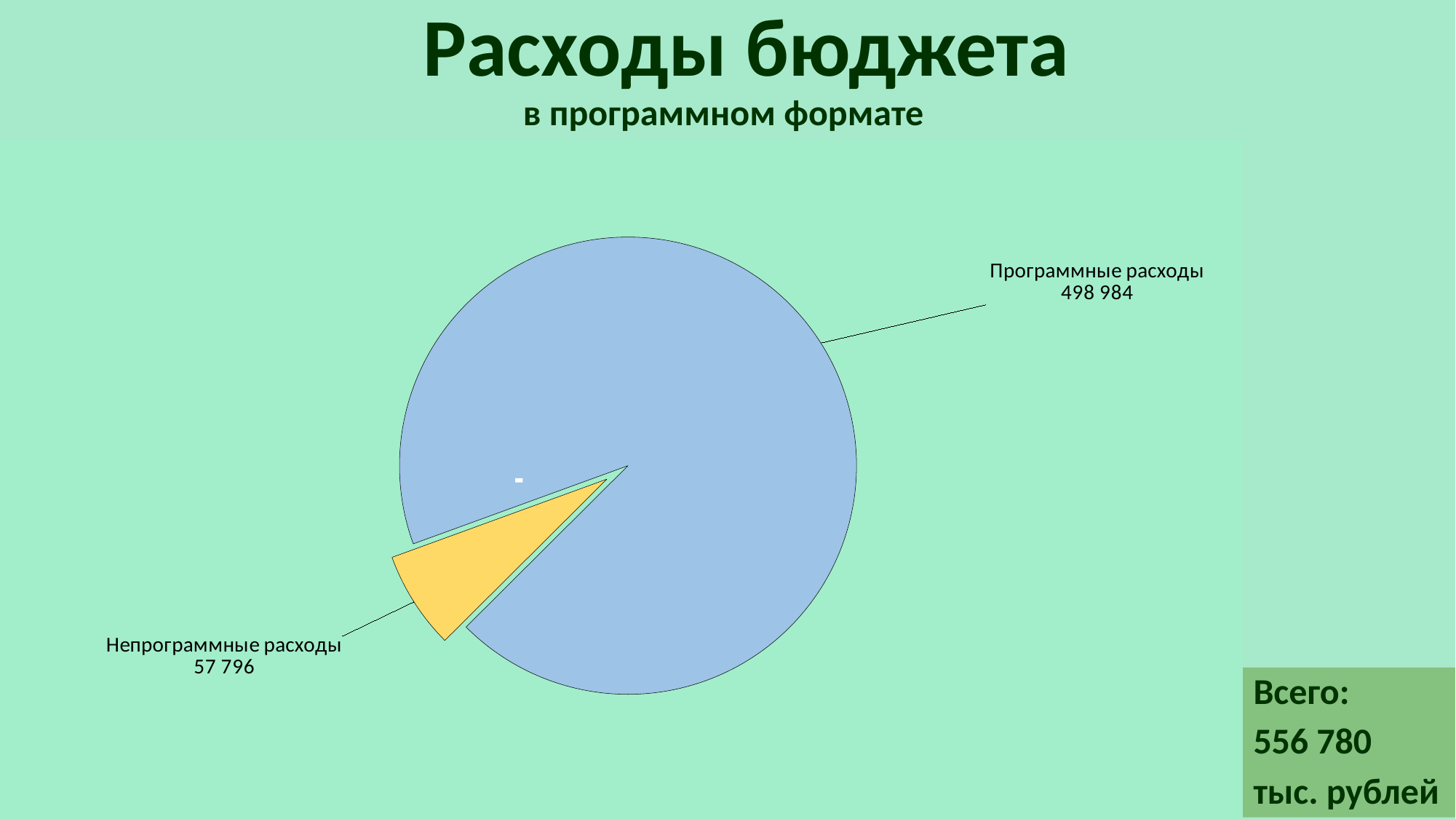
Which category has the smallest slice of the pie? Непрограммные расходы What is the value for Непрограммные расходы? 57 796 What is the title of the chart on the slide? Расходы бюджета в программном формате What is the total of all expenditures shown on the slide? 556 780 тыс. рублей How many slices does the pie chart have? 2 What is the value for Программные расходы? 498 984 What colour is the slice for Непрограммные расходы? yellow What type of chart is shown on the slide? pie chart Which is larger, Программные расходы or Непрограммные расходы? Программные расходы What share of the total do Непрограммные расходы represent? 10.4% Which category has the largest slice of the pie? Программные расходы What is the difference between Программные расходы and Непрограммные расходы? 441 188